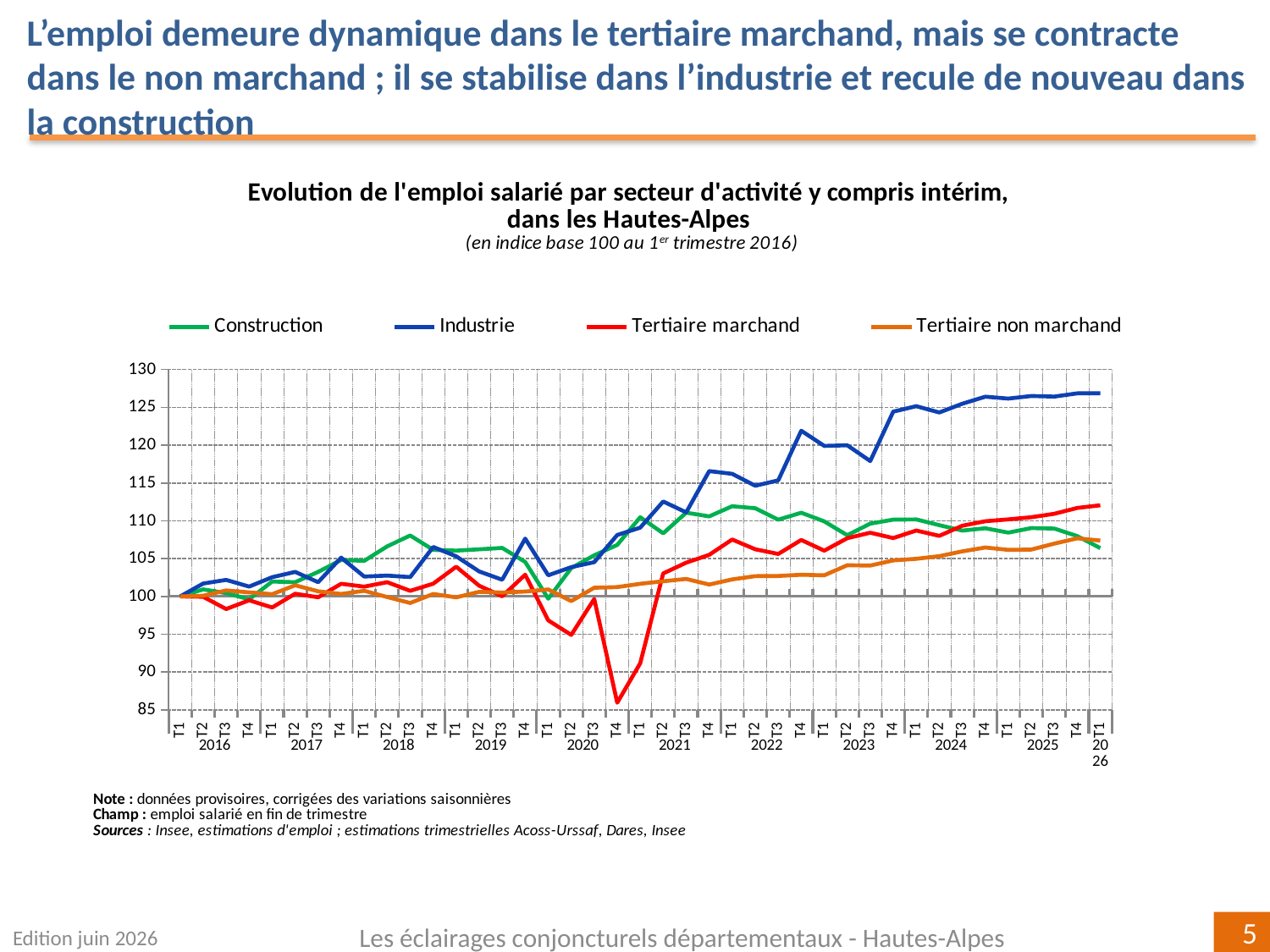
Is the value for Tertiaire marchand at T4 2020 greater or less than 90? less What kind of chart is shown on the slide? line chart According to the chart subtitle, which quarter is the index base 100? 1er trimestre 2016 Is the value for Industrie at T1 2026 greater or less than 125? greater Is the value for Tertiaire non marchand at T1 2026 greater or less than 105? greater At T1 2026, which is larger: Industrie or Construction? Industrie Does the Industrie series rise or fall overall from T1 2016 to T1 2026? rise Which series has the highest value at T1 2026? Industrie At T1 2024, which is larger: Tertiaire marchand or Tertiaire non marchand? Tertiaire marchand Which series reaches the lowest point on the chart, at T4 2020? Tertiaire marchand How many series does the legend list? 4